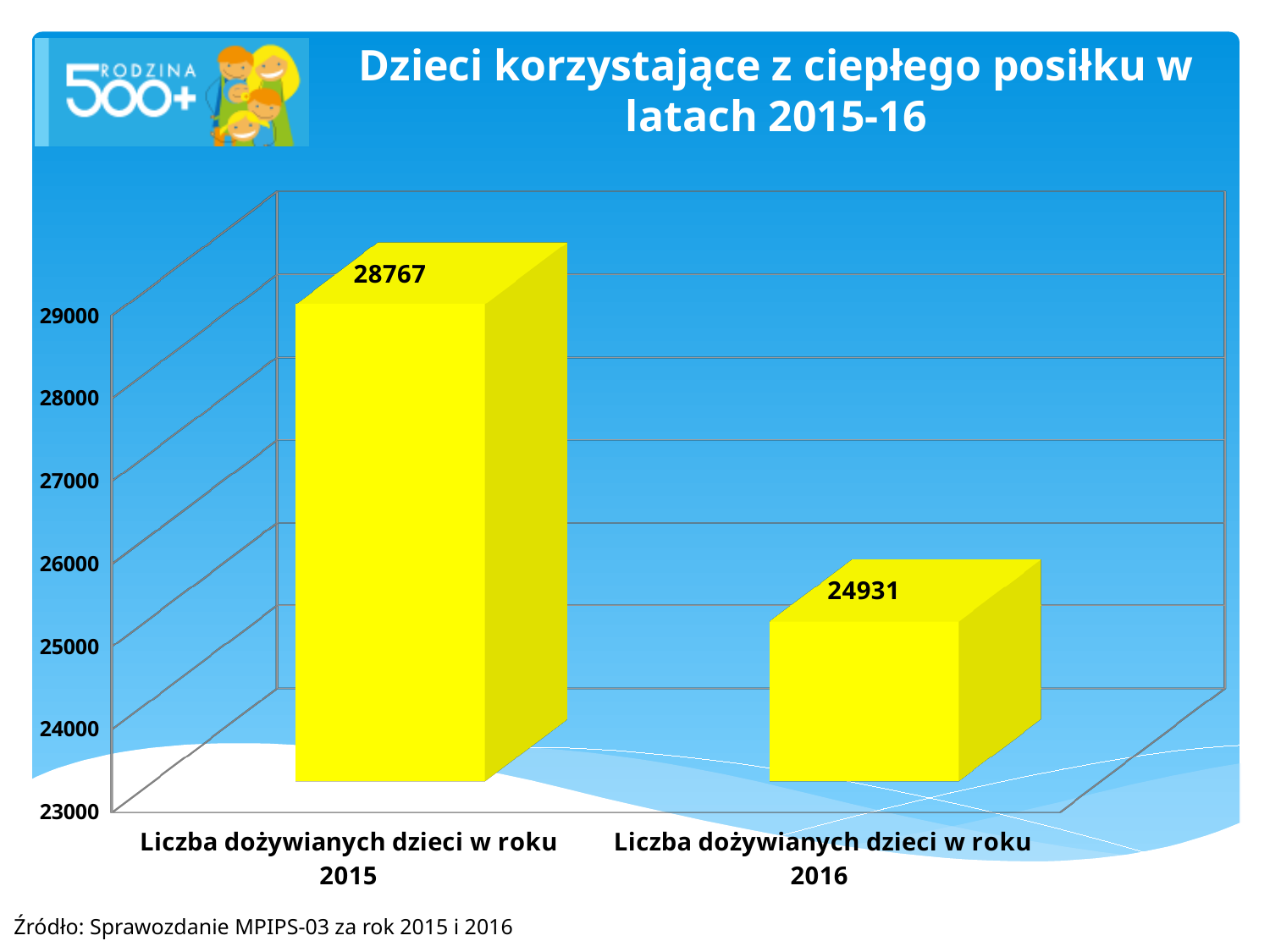
Which is larger, the value for 2015 or the value for 2016? 2015 Do the values rise or fall from 2015 to 2016? fall Is the value for 'Liczba dożywianych dzieci w roku 2015' greater or less than 28000? greater What is the value for 'Liczba dożywianych dzieci w roku 2016'? 24931 What is the difference between the 2015 value and the 2016 value? 3836 What is the title of the chart? Dzieci korzystające z ciepłego posiłku w latach 2015-16 Which category has the lowest value? Liczba dożywianych dzieci w roku 2016 Which category has the highest value? Liczba dożywianych dzieci w roku 2015 What is the value for 'Liczba dożywianych dzieci w roku 2015'? 28767 How many categories are shown in the chart? 2 Is the value for 'Liczba dożywianych dzieci w roku 2016' greater or less than 26000? less What kind of chart is shown on the slide? bar chart